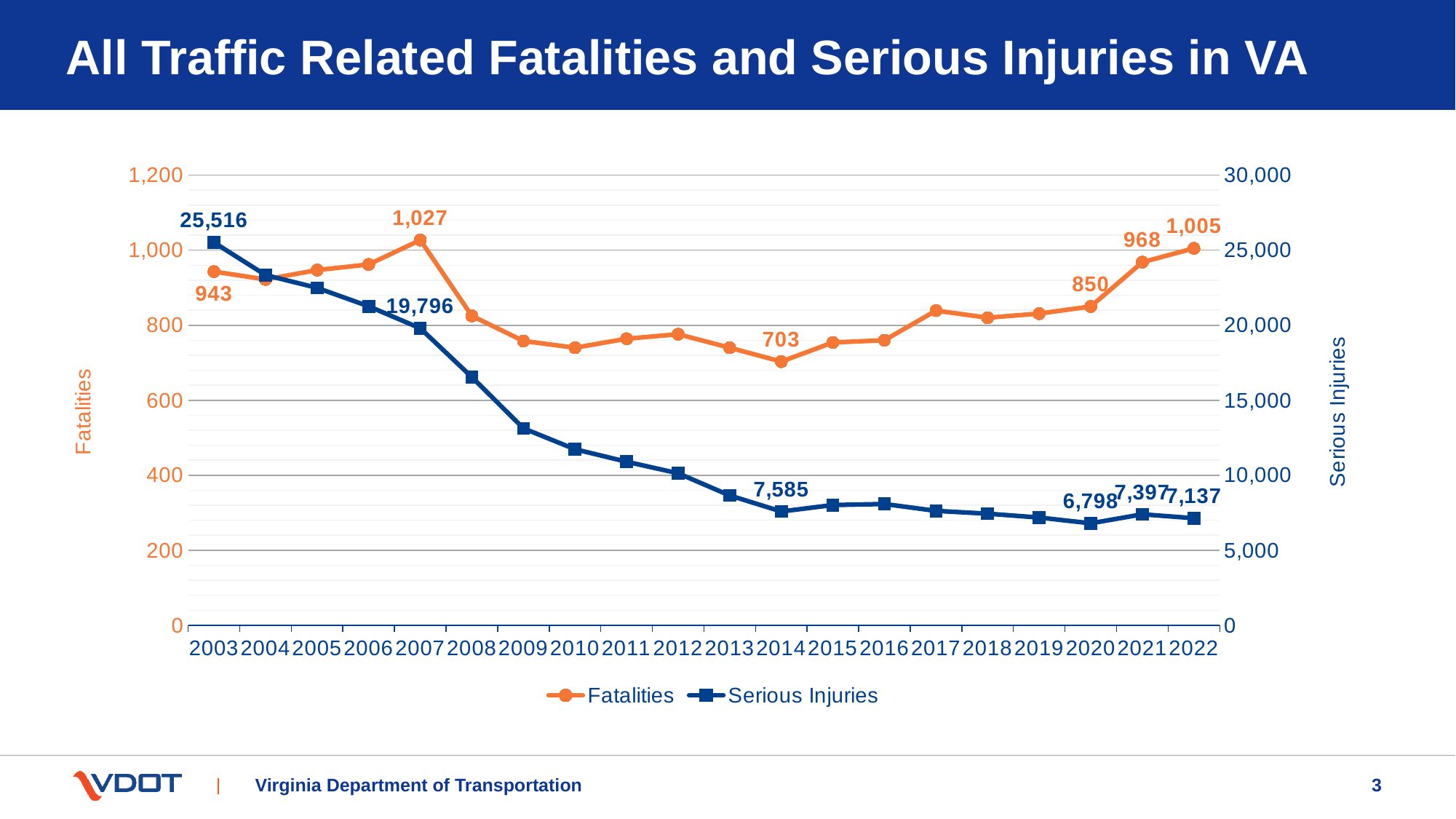
What was the number of Fatalities in 2007? 1,027 Which year had more Fatalities, 2007 or 2022? 2007 What was the number of Serious Injuries in 2003? 25,516 By how much did Fatalities increase from 2021 to 2022? 37 How many series does the legend list? 2 What was the number of Serious Injuries in 2020? 6,798 What kind of chart is shown on the slide? Line chart Is the value for Serious Injuries in 2010 greater or less than 15,000? less Overall, did Serious Injuries rise or fall from 2003 to 2022? Fall How many years are plotted along the x axis? 20 What was the number of Fatalities in 2014? 703 What is the difference in Serious Injuries between 2003 and 2022? 18,379